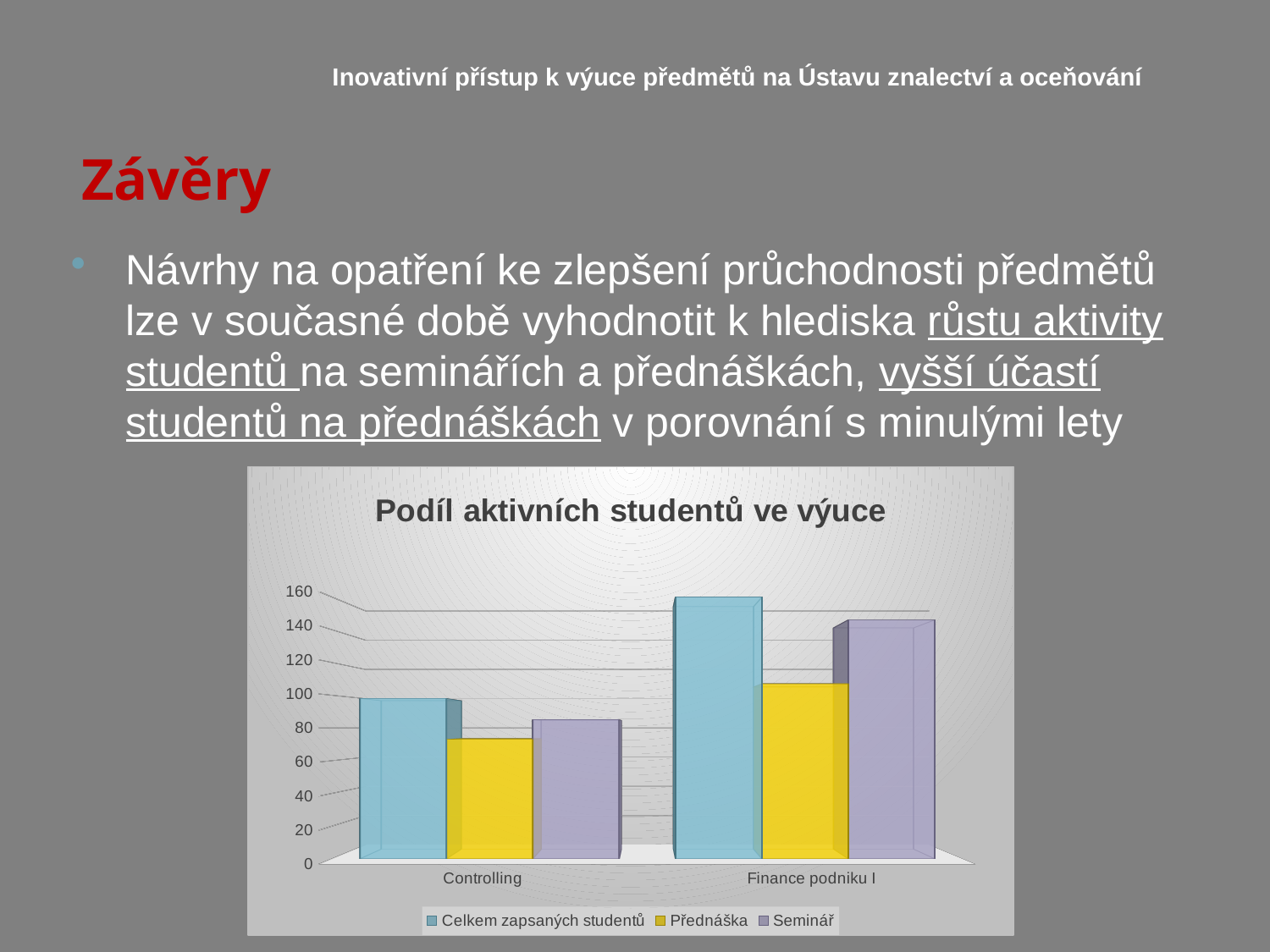
What is the title of the chart? Podíl aktivních studentů ve výuce Is the value for Přednáška in Controlling greater or less than 80? less Which series is shown in yellow in the chart? Přednáška Which is larger: the Seminář value for Controlling or the Seminář value for Finance podniku I? Finance podniku I Is the value for Celkem zapsaných studentů in Finance podniku I greater or less than 140? greater Is the value for Seminář in Finance podniku I greater or less than 120? greater Which series has the lowest value in the Controlling category? Přednáška How many categories are shown on the x axis of the chart? 2 Which category has the highest value for Celkem zapsaných studentů? Finance podniku I How many series does the chart legend list? 3 What kind of chart is shown on the slide? bar chart Do the values for Přednáška rise or fall from Controlling to Finance podniku I? rise